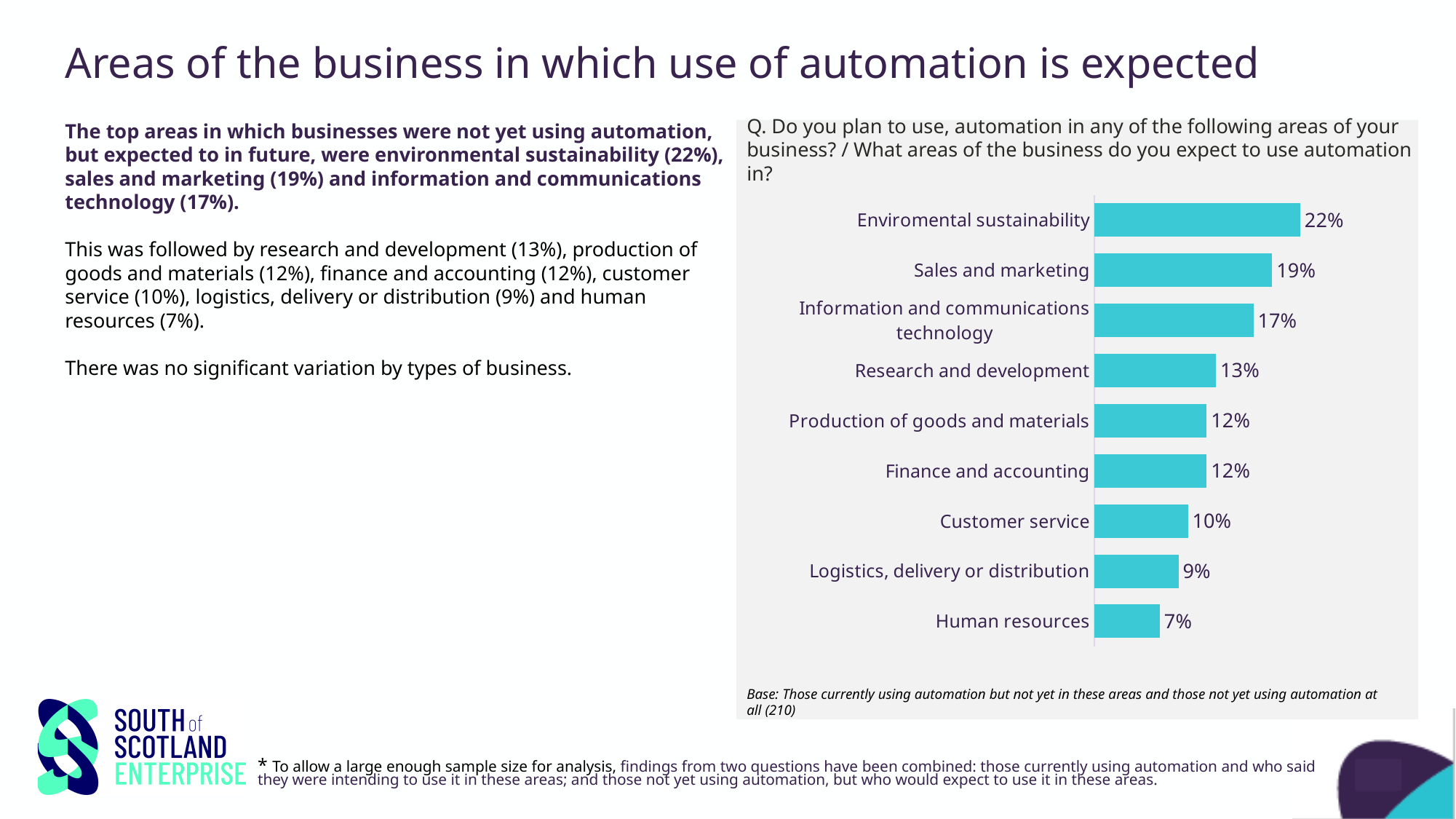
What is the base size stated below the chart? 210 How many areas of the business are listed in the chart? 9 What percentage is shown for Customer service? 10% What is the value for Logistics, delivery or distribution? 9% What is the value shown for Sales and marketing? 19% What type of chart is shown on the slide? Bar chart Which area has the highest percentage in the chart? Enviromental sustainability What is the difference in percentage points between Enviromental sustainability and Human resources? 15 Which is larger: the value for Research and development or the value for Customer service? Research and development What is the difference in percentage points between Sales and marketing and Information and communications technology? 2 Which area has the lowest percentage in the chart? Human resources What percentage of businesses expect to use automation in environmental sustainability? 22%